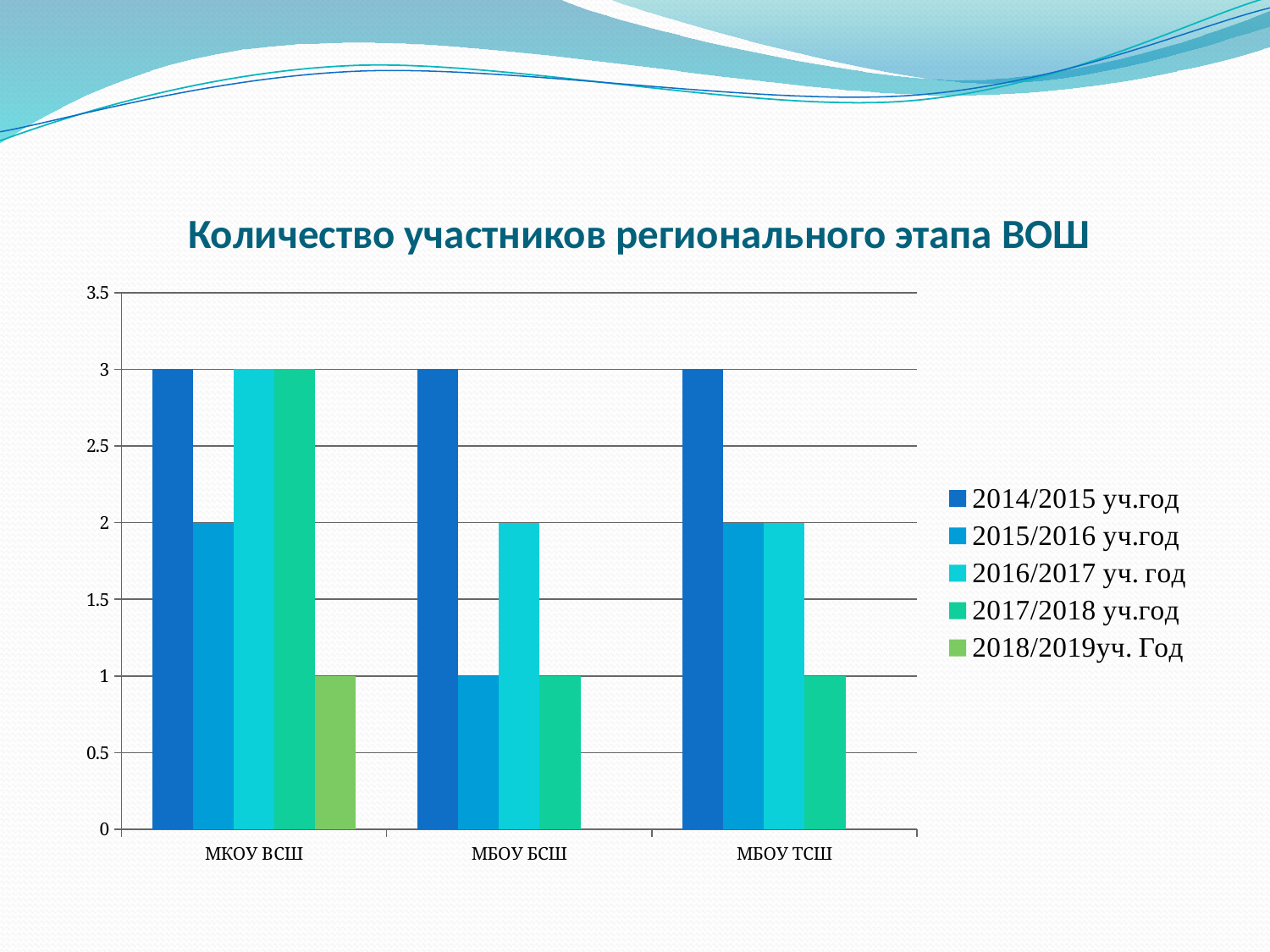
Which category has the lowest value for 2015/2016 уч.год? МБОУ БСШ What is the value for МБОУ БСШ in 2016/2017 уч. год? 2 What kind of chart is shown on the slide? bar chart How many categories are shown on the x axis? 3 What is the value for МБОУ ТСШ in 2017/2018 уч.год? 1 What is the title of the chart? Количество участников регионального этапа ВОШ Which category has the highest value for 2018/2019уч. Год? МКОУ ВСШ Which is larger for МБОУ ТСШ: the 2015/2016 уч.год value or the 2017/2018 уч.год value? 2015/2016 уч.год What is the value for МКОУ ВСШ in 2018/2019уч. Год? 1 What is the difference between the 2014/2015 уч.год and 2015/2016 уч.год values for МБОУ БСШ? 2 What is the value for МКОУ ВСШ in 2015/2016 уч.год? 2 How many series does the legend list? 5